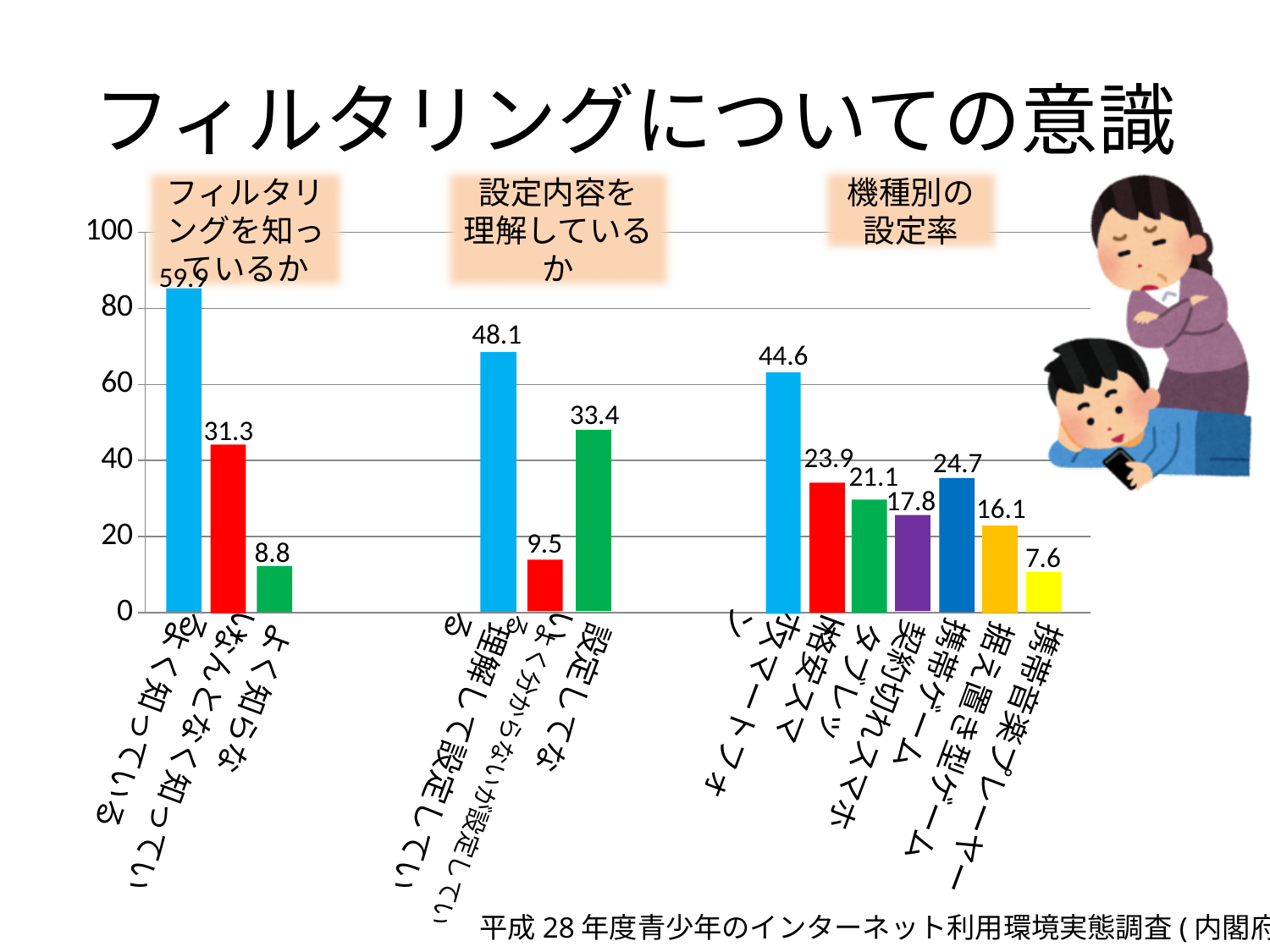
In the 設定内容を理解しているか group, which category has the lowest value? よく分からないが設定している In the 機種別の設定率 group, what is the value for 携帯音楽プレーヤー? 7.6 In the 設定内容を理解しているか group, what is the value for 設定していない? 33.4 What is the difference between the values for 理解して設定している (48.1) and 設定していない (33.4)? 14.7 In the 機種別の設定率 group, which device has the highest value? スマートフォン How many bars are in the 機種別の設定率 group? 7 What type of chart is shown on the slide? bar chart Which is larger: the value for タブレット or the value for 契約切れスマホ? タブレット In the フィルタリングを知っているか group, what is the value for よく知らない? 8.8 In the 機種別の設定率 group, what is the value for スマートフォン? 44.6 In the 機種別の設定率 group, which device has the lowest value? 携帯音楽プレーヤー What is the difference between the values for 格安スマホ (23.9) and 携帯ゲーム (24.7)? 0.8